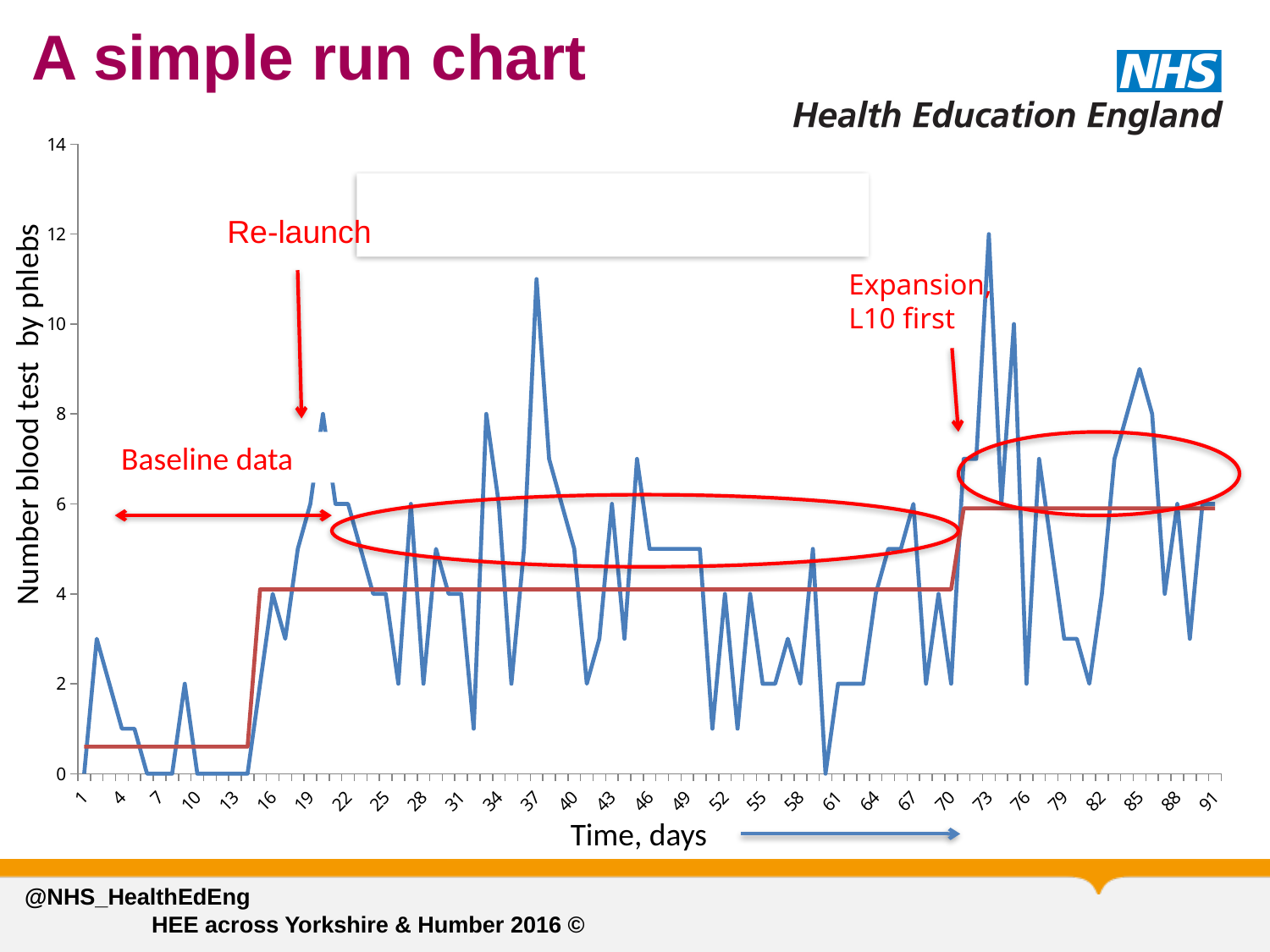
What is the title of the vertical axis? Number blood test by phlebs Which day has the highest value on the blue line? 73 Which is larger, the value for day 37 or the value for day 73? day 73 What is the title of the horizontal axis? Time, days What kind of chart is shown on the slide? line chart Is the value for day 37 greater or less than 10? greater Is the value for day 73 greater or less than 10? greater Is the value for day 16 greater or less than 6? less Does the red step line rise or fall as time increases along the x axis? rise